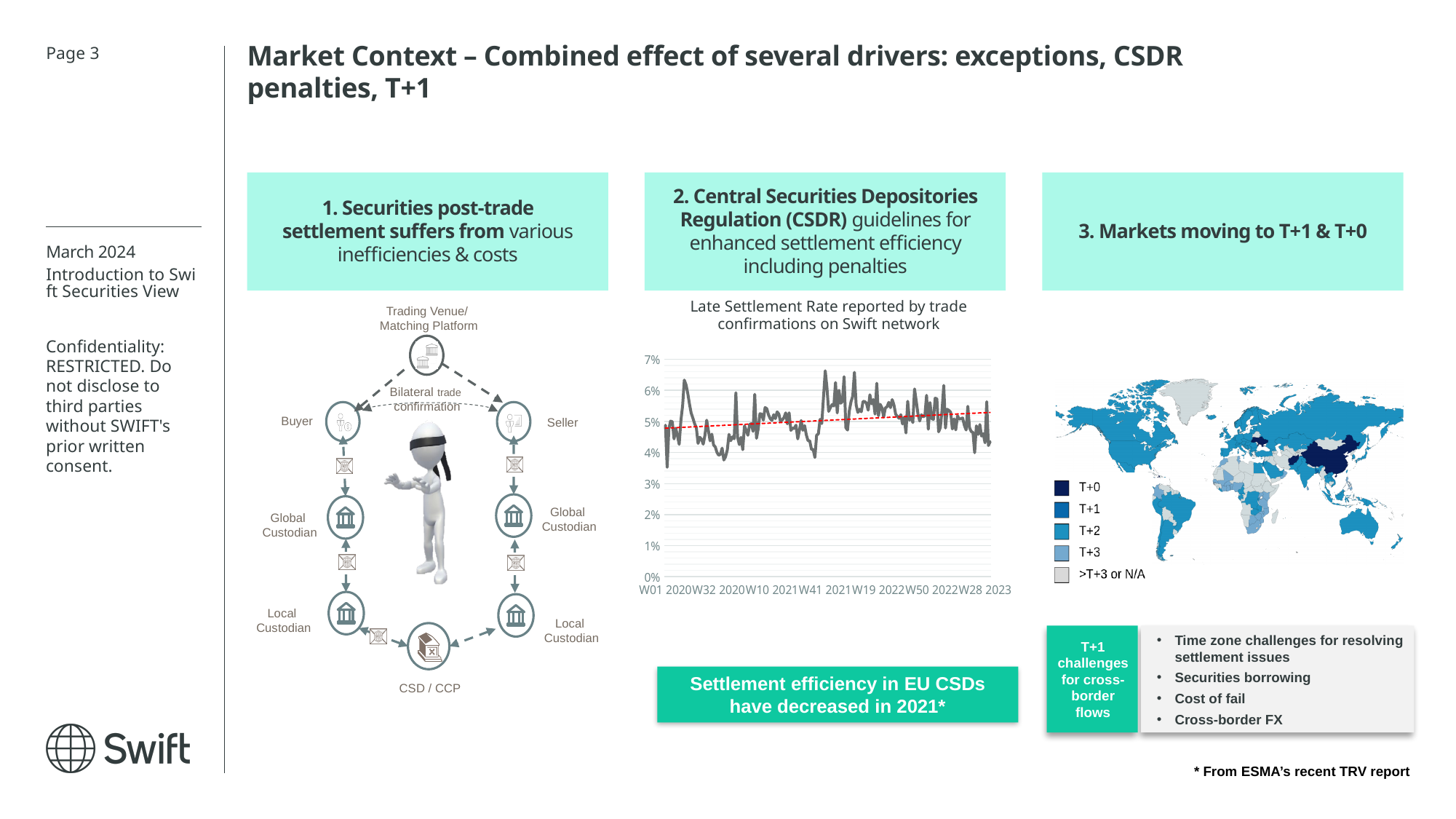
What is the highest value shown on the y axis of the Late Settlement Rate chart? 7% In the Late Settlement Rate chart, does the red dashed trend line rise or fall from left to right? rise What is the title of the chart in the middle of the slide? Late Settlement Rate reported by trade confirmations on Swift network In the Late Settlement Rate chart, is the peak value of the line greater or less than 6%? greater In the Late Settlement Rate chart, is the value at the last point (W28 2023) greater or less than 3%? greater What kind of chart is used to show the Late Settlement Rate reported by trade confirmations on Swift network? line chart In the Late Settlement Rate chart, is the value at the first point (W01 2020) greater or less than 6%? less